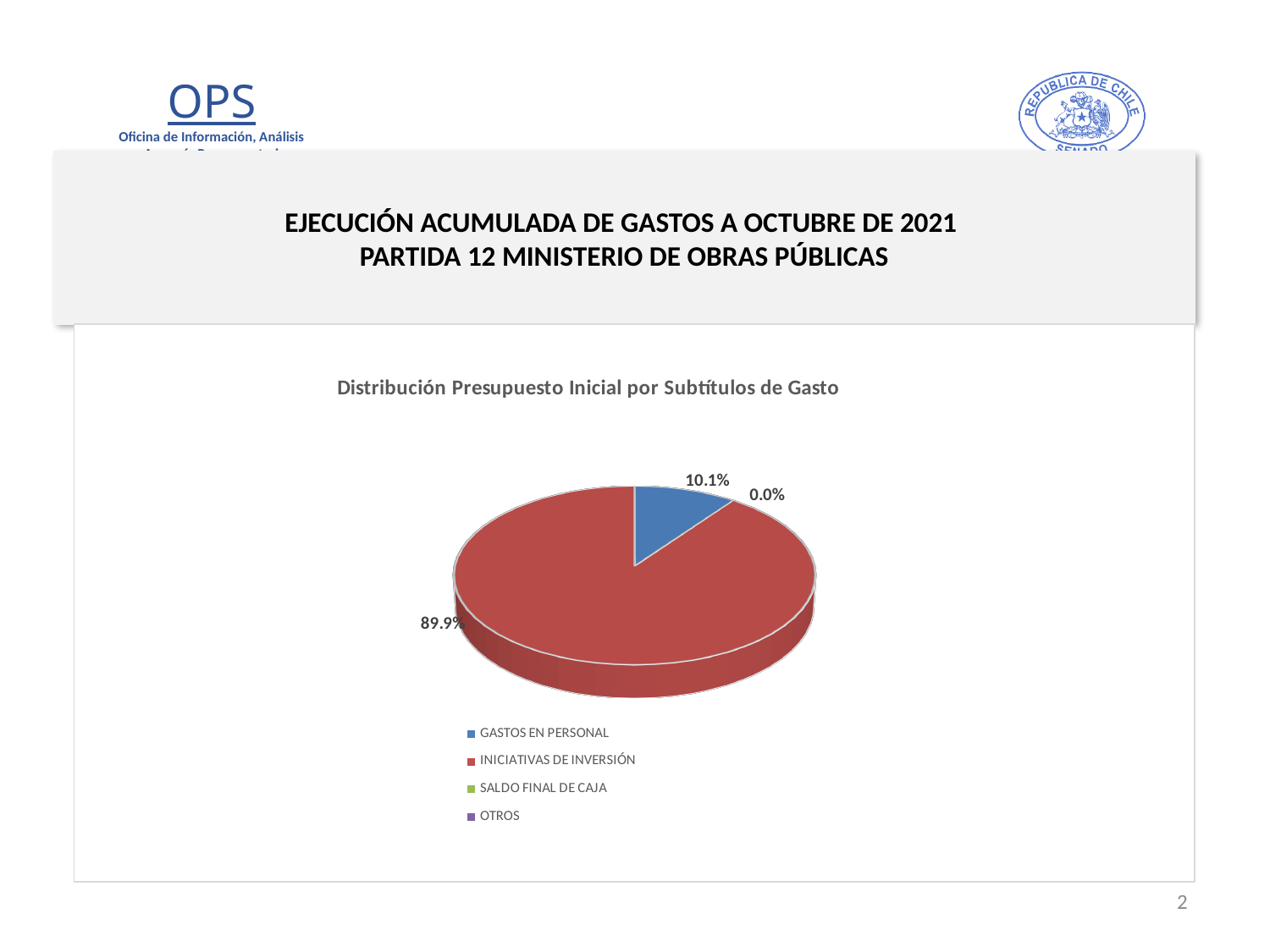
What is the combined share of GASTOS EN PERSONAL and INICIATIVAS DE INVERSIÓN? 100.0% What is the title of the pie chart? Distribución Presupuesto Inicial por Subtítulos de Gasto What is the difference in percentage points between the INICIATIVAS DE INVERSIÓN share and the GASTOS EN PERSONAL share? 79.8 percentage points Is the share for INICIATIVAS DE INVERSIÓN greater or less than 50%? greater Which category has the largest slice of the pie? INICIATIVAS DE INVERSIÓN Which is larger, the share for GASTOS EN PERSONAL or the share for INICIATIVAS DE INVERSIÓN? INICIATIVAS DE INVERSIÓN What kind of chart is shown on the slide? Pie chart Which is smaller, the share for GASTOS EN PERSONAL or the share for INICIATIVAS DE INVERSIÓN? GASTOS EN PERSONAL What share of the pie is labelled for INICIATIVAS DE INVERSIÓN? 89.9% How many categories does the legend of the pie chart list? 4 What share of the pie is labelled for GASTOS EN PERSONAL? 10.1% What colour is the slice for INICIATIVAS DE INVERSIÓN? Red